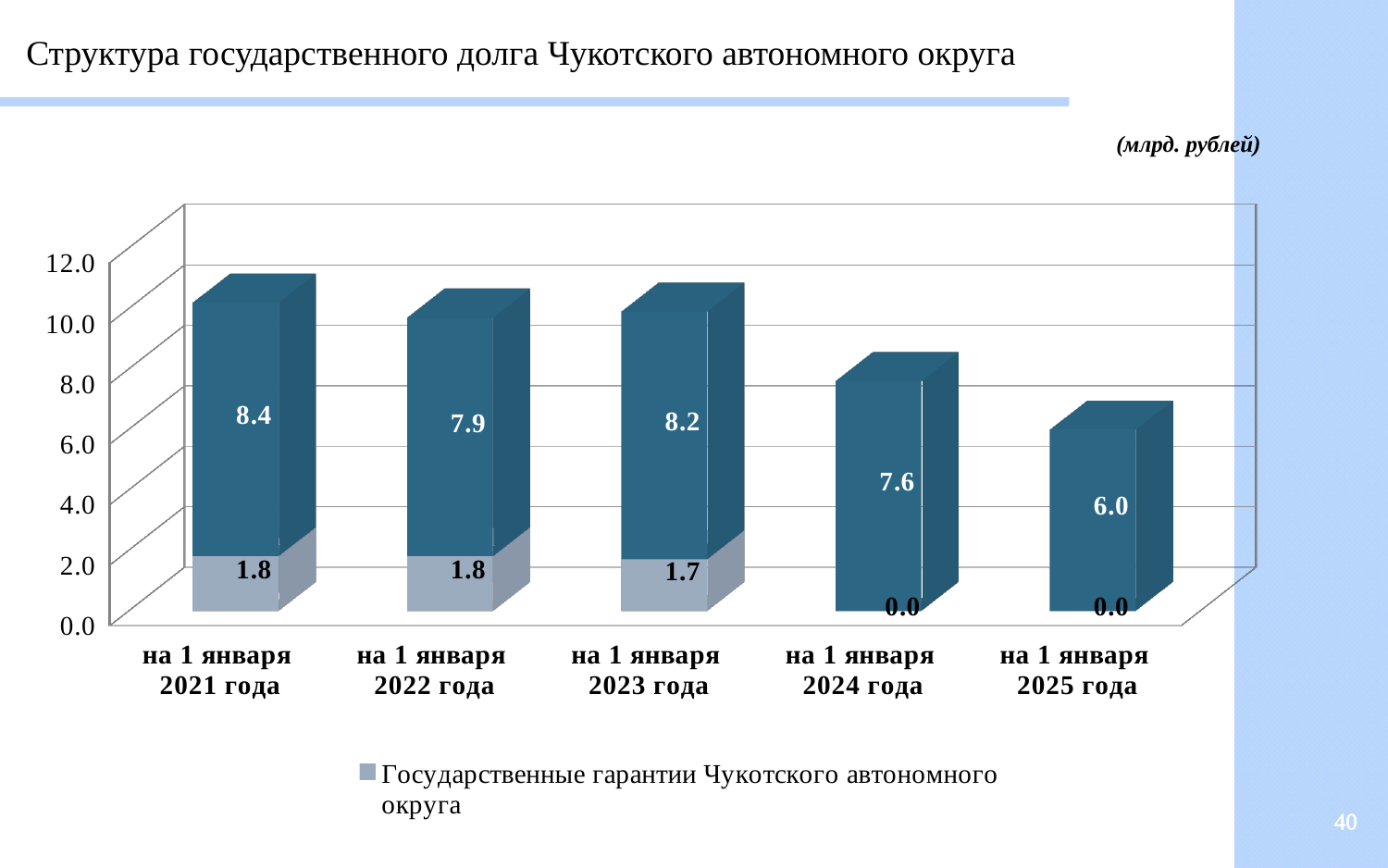
Which category has the lowest value for the dark blue segment? на 1 января 2025 года Which category has the highest value for the dark blue segment? на 1 января 2021 года What kind of chart is shown on the slide? Stacked bar chart What is the value of the Государственные гарантии Чукотского автономного округа segment for на 1 января 2021 года? 1.8 What unit is stated for the values on the chart? млрд. рублей What is the difference between the dark blue segment values for на 1 января 2021 года and на 1 января 2025 года? 2.4 What is the value of the Государственные гарантии Чукотского автономного округа segment for на 1 января 2023 года? 1.7 What is the total of the stacked bar for на 1 января 2021 года? 10.2 What is the value of the dark blue segment for на 1 января 2025 года? 6.0 How many categories are shown on the x axis? 5 What is the total of the stacked bar for на 1 января 2023 года? 9.9 What is the value of the dark blue segment for на 1 января 2024 года? 7.6